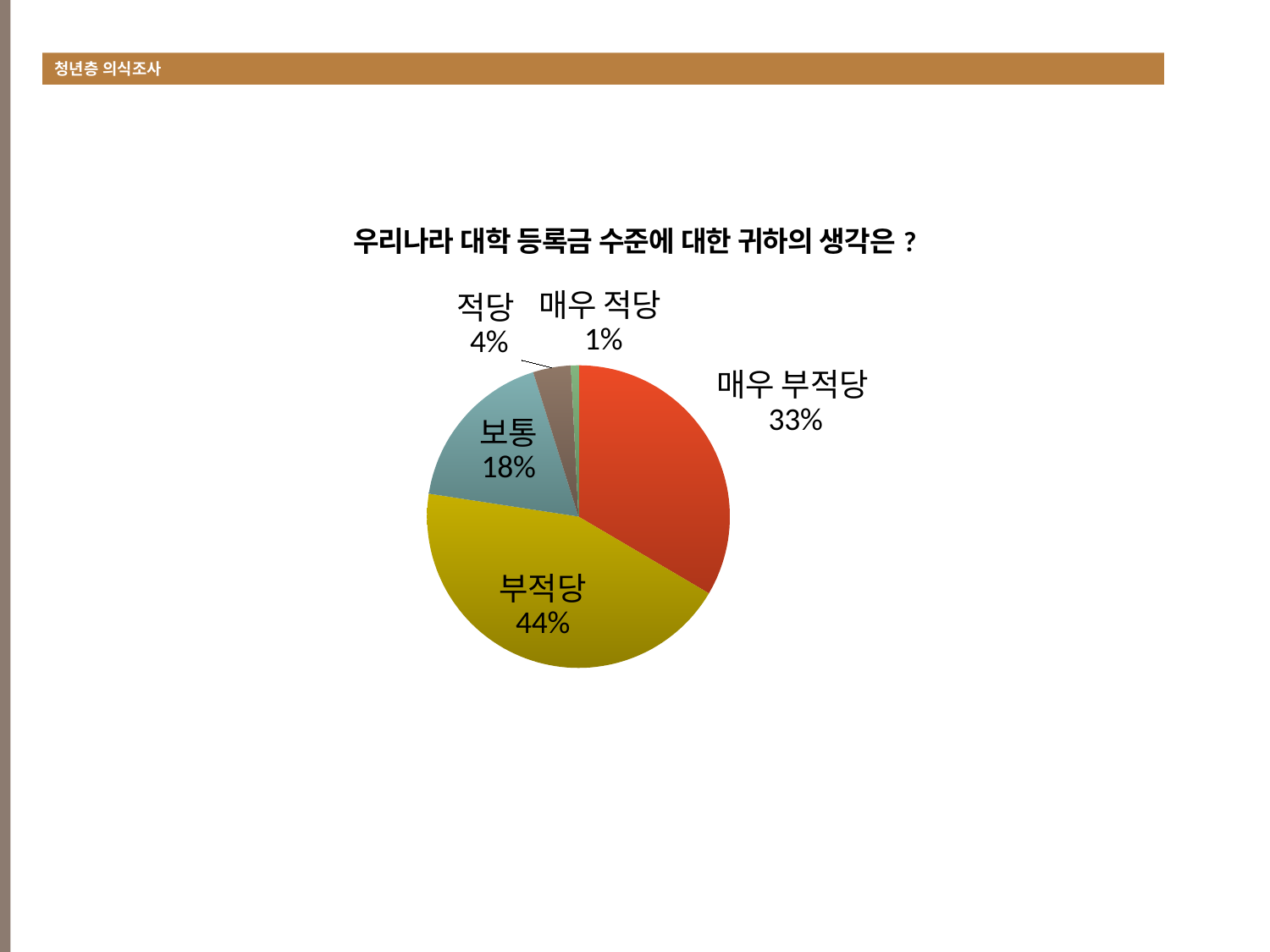
Which response has the largest share of the pie? 부적당 What percentage of respondents answered 보통? 18% What percentage of respondents answered 적당? 4% What percentage of respondents answered 매우 적당? 1% What kind of chart is shown on the slide? pie chart What percentage of respondents answered 부적당? 44% Which response has the smallest share of the pie? 매우 적당 What is the title of the chart? 우리나라 대학 등록금 수준에 대한 귀하의 생각은 ? What percentage of respondents answered 매우 부적당? 33% How many slices does the pie chart have? 5 What is the difference in percentage points between 부적당 and 매우 부적당? 11 Which is larger, the share for 보통 or the share for 적당? 보통